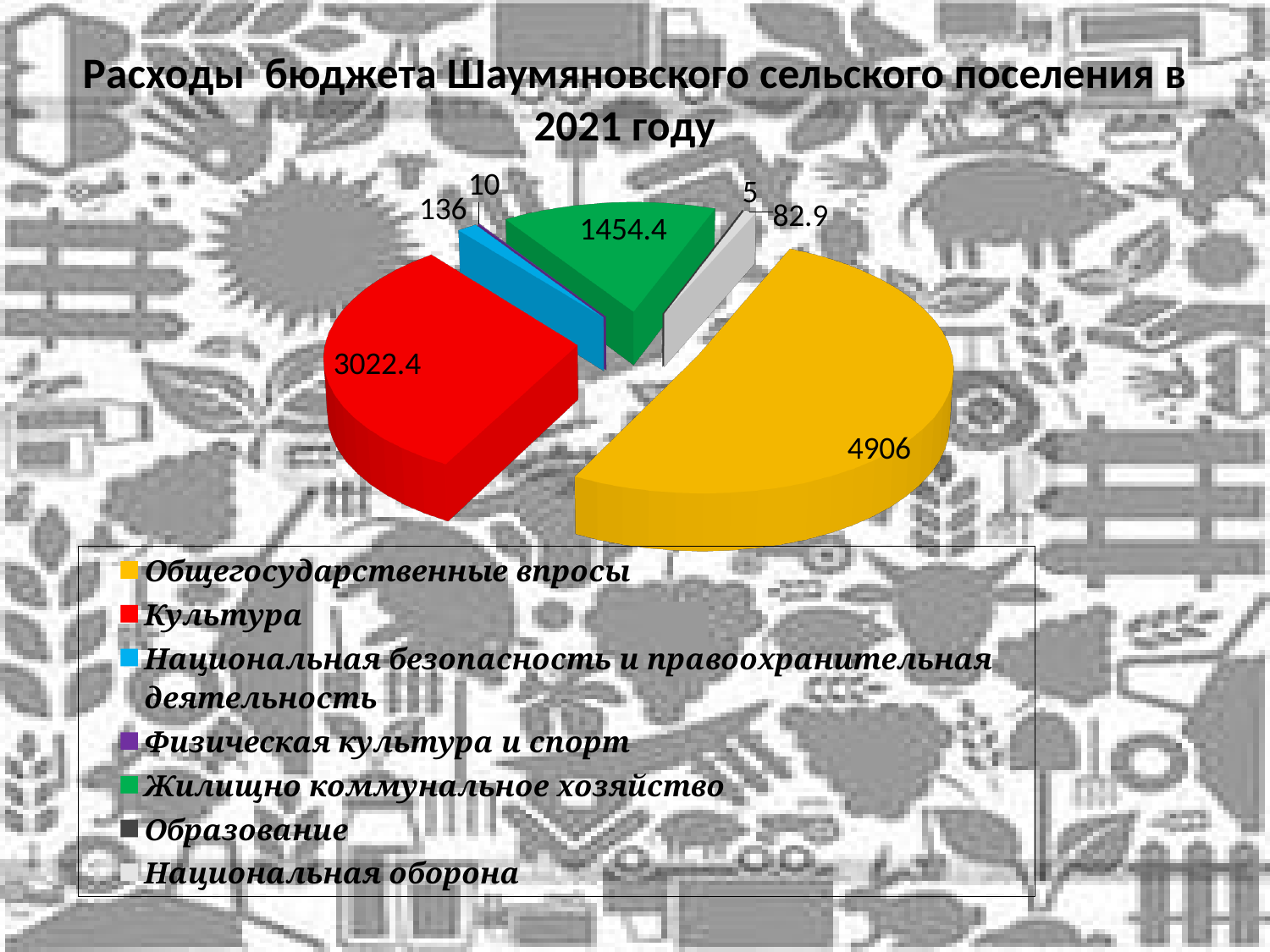
What is the value for Национальная безопасность и правоохранительная деятельность? 136 What is the value for Жилищно коммунальное хозяйство? 1454.4 What type of chart is shown on the slide? Pie chart What is the title of the chart? Расходы бюджета Шаумяновского сельского поселения в 2021 году Which category has the largest slice of the pie? Общегосударственные впросы How many categories does the legend list? 7 What is the value for Национальная оборона? 82.9 What is the value for Культура? 3022.4 Which is larger: Жилищно коммунальное хозяйство or Культура? Культура What is the value for Общегосударственные впросы? 4906 Which category has the smallest value? Образование What is the difference between the values for Общегосударственные впросы and Культура? 1883.6